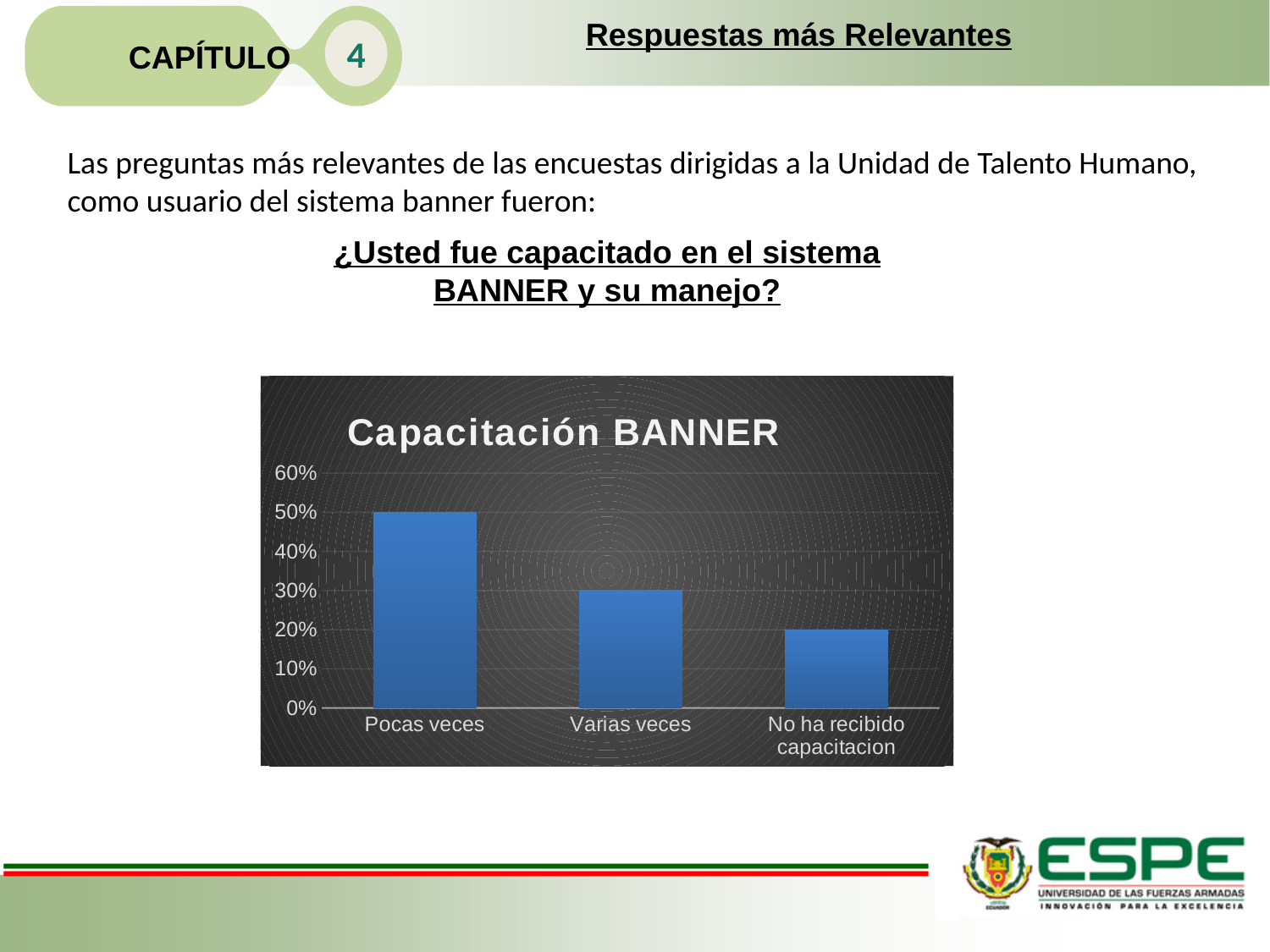
What is the value for Pocas veces? 50% What is the value for Varias veces? 30% What is the value for No ha recibido capacitacion? 20% What is the difference between the values for Pocas veces and Varias veces? 20% Which is larger, the value for Varias veces or the value for No ha recibido capacitacion? Varias veces How many categories are shown on the x axis of the chart? 3 Which category has the lowest value? No ha recibido capacitacion Do the values rise or fall from left to right along the x axis? fall Which category has the highest value? Pocas veces What is the title of the chart? Capacitación BANNER Is the value for Pocas veces greater or less than 40%? greater What kind of chart is shown on the slide? bar chart